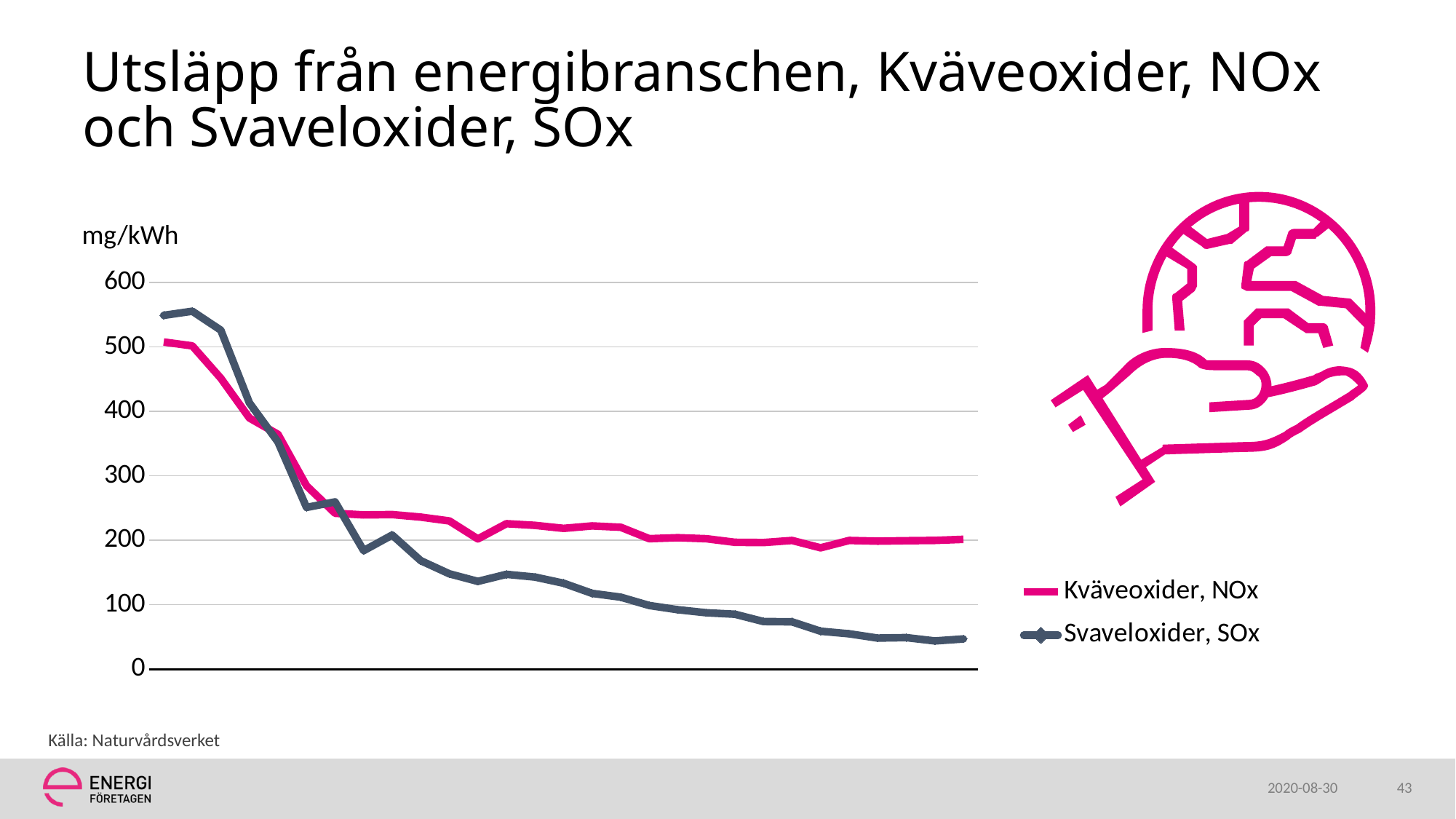
At the start of the series, which is larger: Kväveoxider, NOx or Svaveloxider, SOx? Svaveloxider, SOx What unit is shown on the y axis of the chart? mg/kWh Do the values for Kväveoxider, NOx rise or fall along the x axis overall? fall Do the values for Svaveloxider, SOx rise or fall along the x axis overall? fall At the end of the series, which is larger: Kväveoxider, NOx or Svaveloxider, SOx? Kväveoxider, NOx Which two series are listed in the legend? Kväveoxider, NOx and Svaveloxider, SOx Is the value for Kväveoxider, NOx at the start of the series greater or less than 600? less Is the value for Kväveoxider, NOx at the end of the series greater or less than 100? greater How many series does the legend list? 2 Is the value for Svaveloxider, SOx at the start of the series greater or less than 500? greater What kind of chart is shown on the slide? line chart